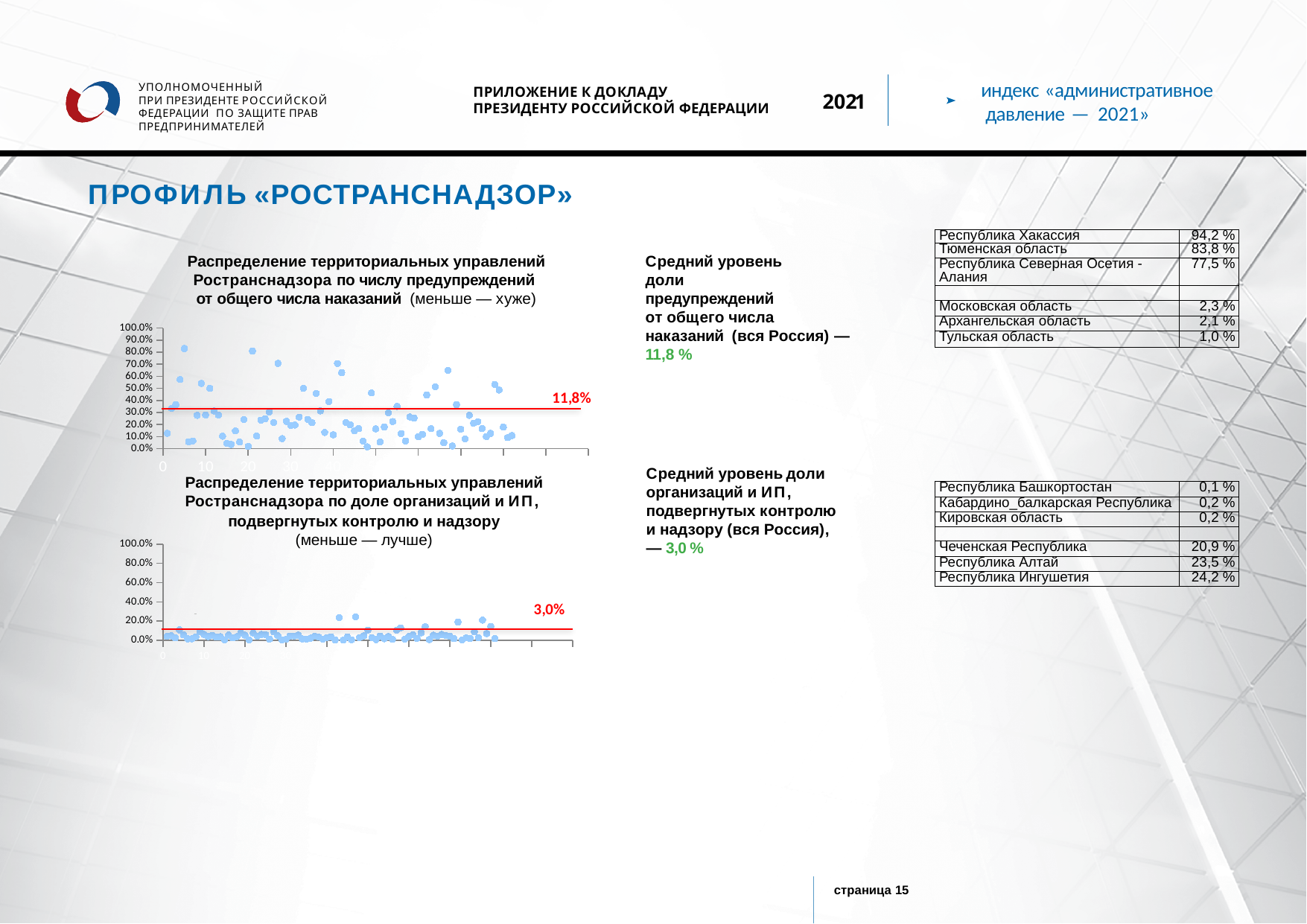
On the bottom chart, is the red reference line value greater or less than 20.0%? less What kind of chart is the bottom chart on the slide? scatter chart On the bottom chart (distribution by share of organisations and sole proprietors subject to control), what value is printed on the red horizontal reference line? 3,0% On the top chart, is the red reference line value greater or less than 20.0%? less Which chart has the higher red reference line value, the top chart or the bottom chart? the top chart What is the maximum value shown on the y axis of the top chart? 100.0% On the top chart (distribution by share of warnings), what value is printed on the red horizontal reference line? 11,8% What colour are the data points on the top chart? light blue What kind of chart is the top chart on the slide? scatter chart What is the difference between the red reference line values of the top chart (11,8%) and the bottom chart (3,0%)? 8,8%